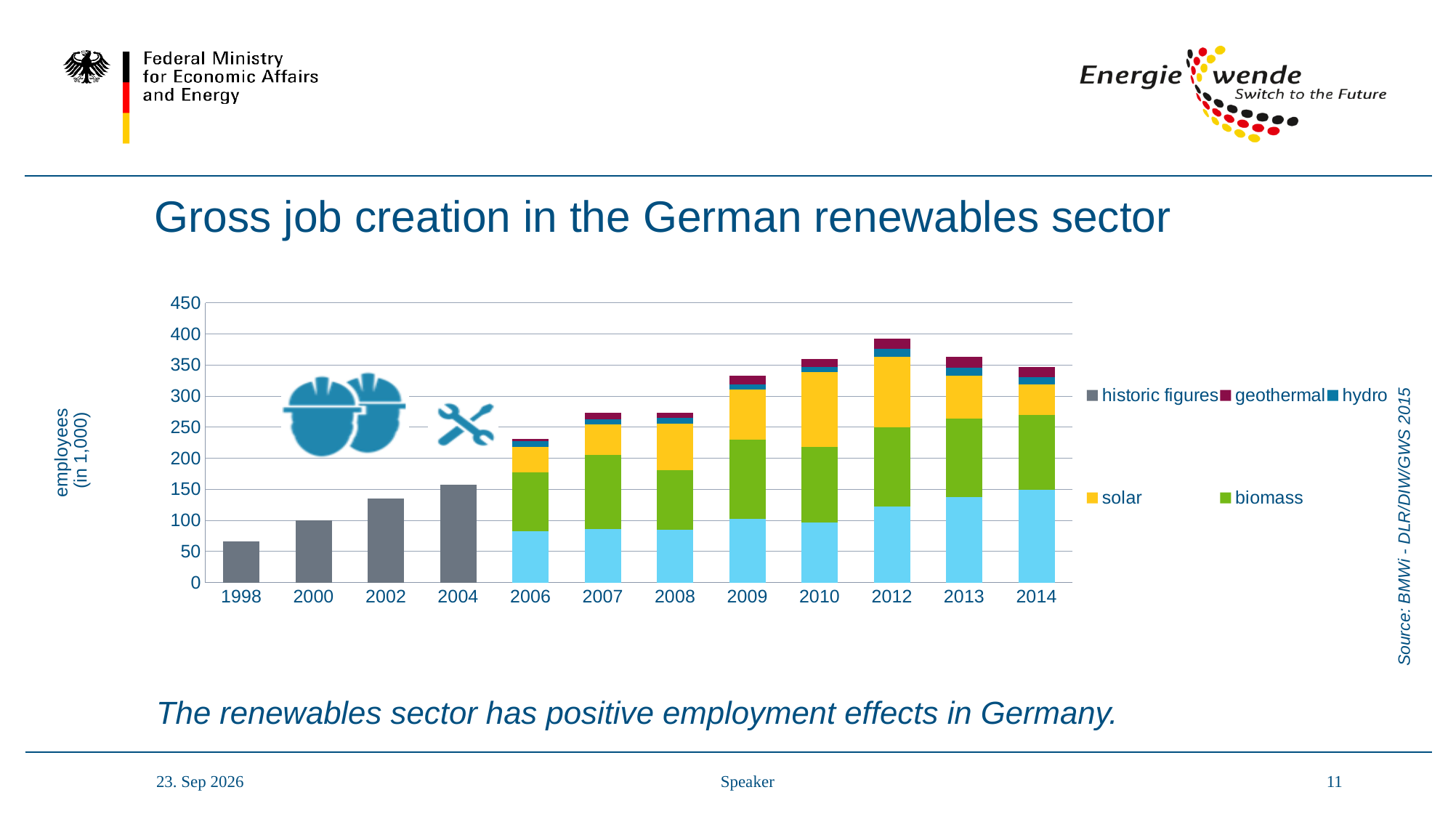
What kind of chart is shown on the slide? stacked bar chart Is the total value for 2012 greater or less than 400? less What is the label on the y axis of the chart? employees (in 1,000) How many years are shown on the x axis of the chart? 12 How many series does the chart's legend list? 5 Is the total value for 2006 greater or less than 200? greater Which year has the lowest bar in the chart? 1998 Which year has the highest total bar in the chart? 2012 Which year has the larger total bar, 2012 or 2014? 2012 Is the total value for 2009 greater or less than 300? greater Do the historic figures bars rise or fall from 1998 to 2004? rise